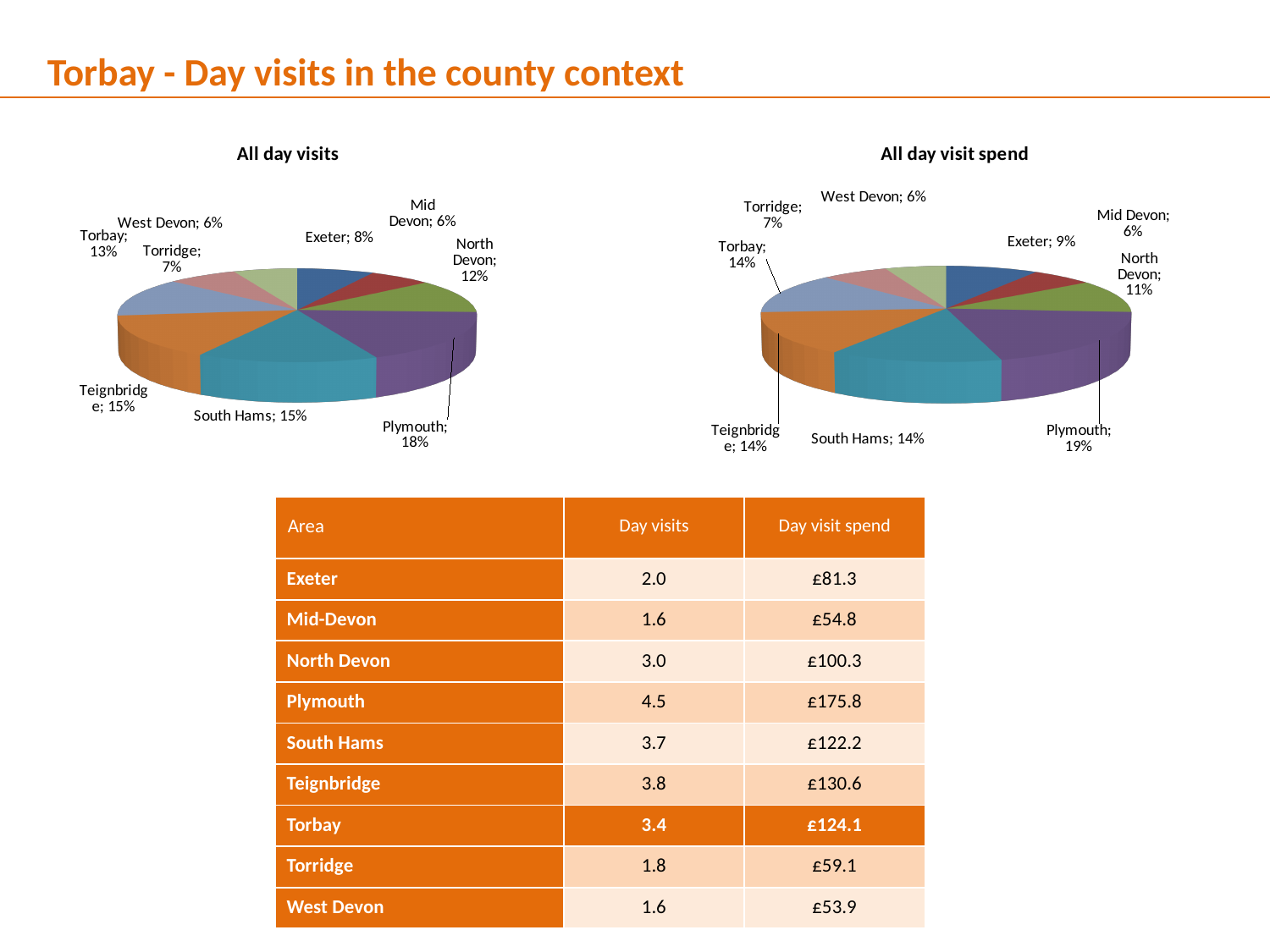
How many areas are shown as slices in the 'All day visits' chart? 9 In the 'All day visit spend' chart, what share does North Devon account for? 11% In the 'All day visits' chart, what share of day visits does Torbay account for? 13% In the 'All day visit spend' chart, which area has the largest share? Plymouth In the 'All day visits' chart, which is larger, Torbay's share or Exeter's share? Torbay In the 'All day visit spend' chart, what share does Plymouth account for? 19% In the 'All day visits' chart, which area has the largest slice? Plymouth In the 'All day visits' chart, what is the difference in percentage points between Plymouth and Exeter? 10 percentage points What is the title of the pie chart on the left of the slide? All day visits In the 'All day visits' chart, what share does South Hams account for? 15% In the 'All day visit spend' chart, which is larger, Torbay's share or Torridge's share? Torbay What type of chart is the 'All day visit spend' chart? Pie chart